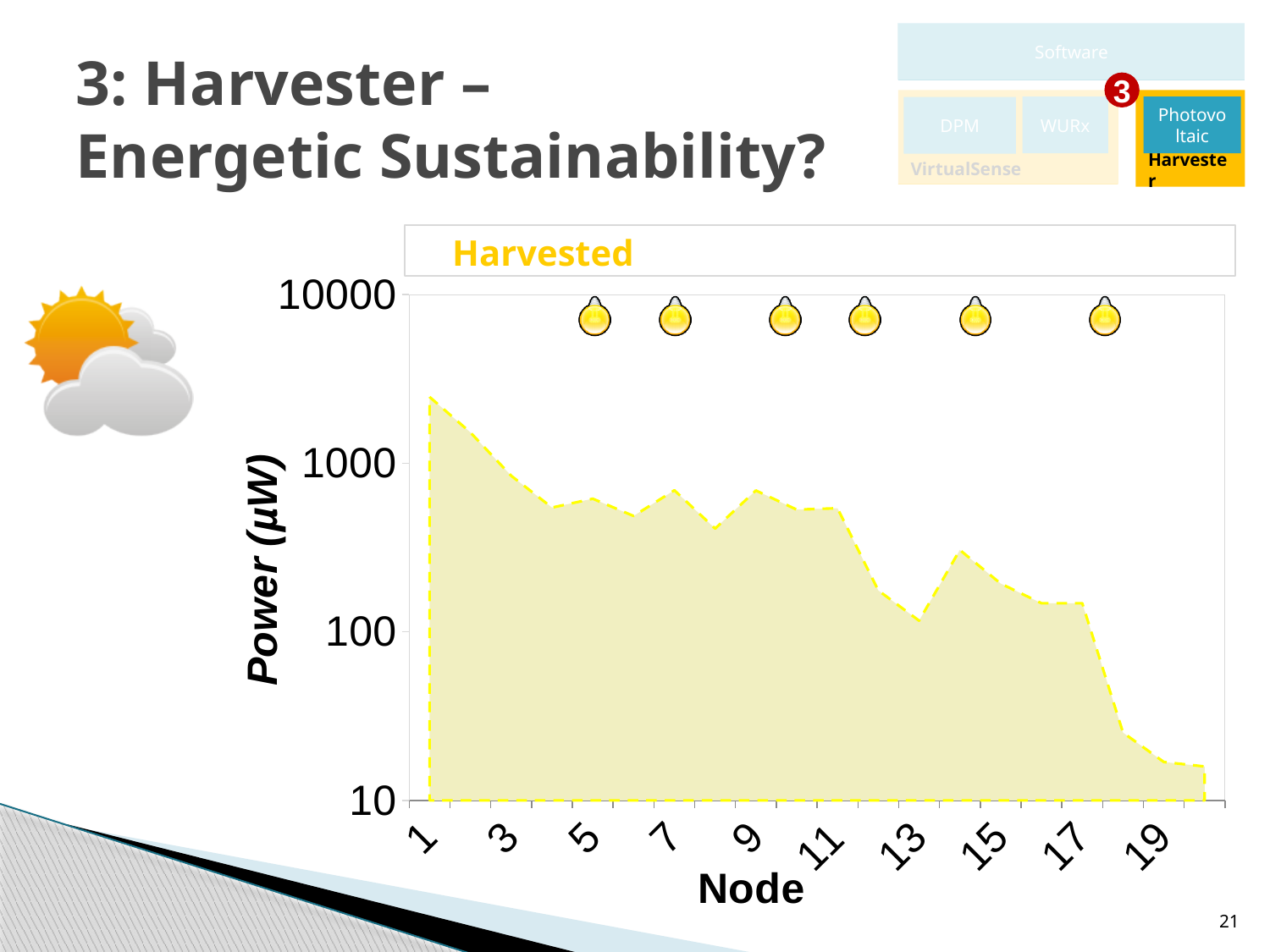
Which has the larger harvested power, node 1 or node 19? Node 1 What is the label of the y axis of the chart? Power (µW) Do the harvested power values generally rise or fall from node 1 to node 19? Fall What is the name of the series shown in the chart legend? Harvested Which has the larger harvested power, node 9 or node 15? Node 9 Is the harvested power for node 5 greater or less than 1000? less Which node has the highest harvested power? Node 1 How many series does the chart legend list? 1 Is the harvested power for node 1 greater or less than 1000? greater What kind of chart is shown on the slide? Area chart Is the harvested power for node 19 greater or less than 100? less